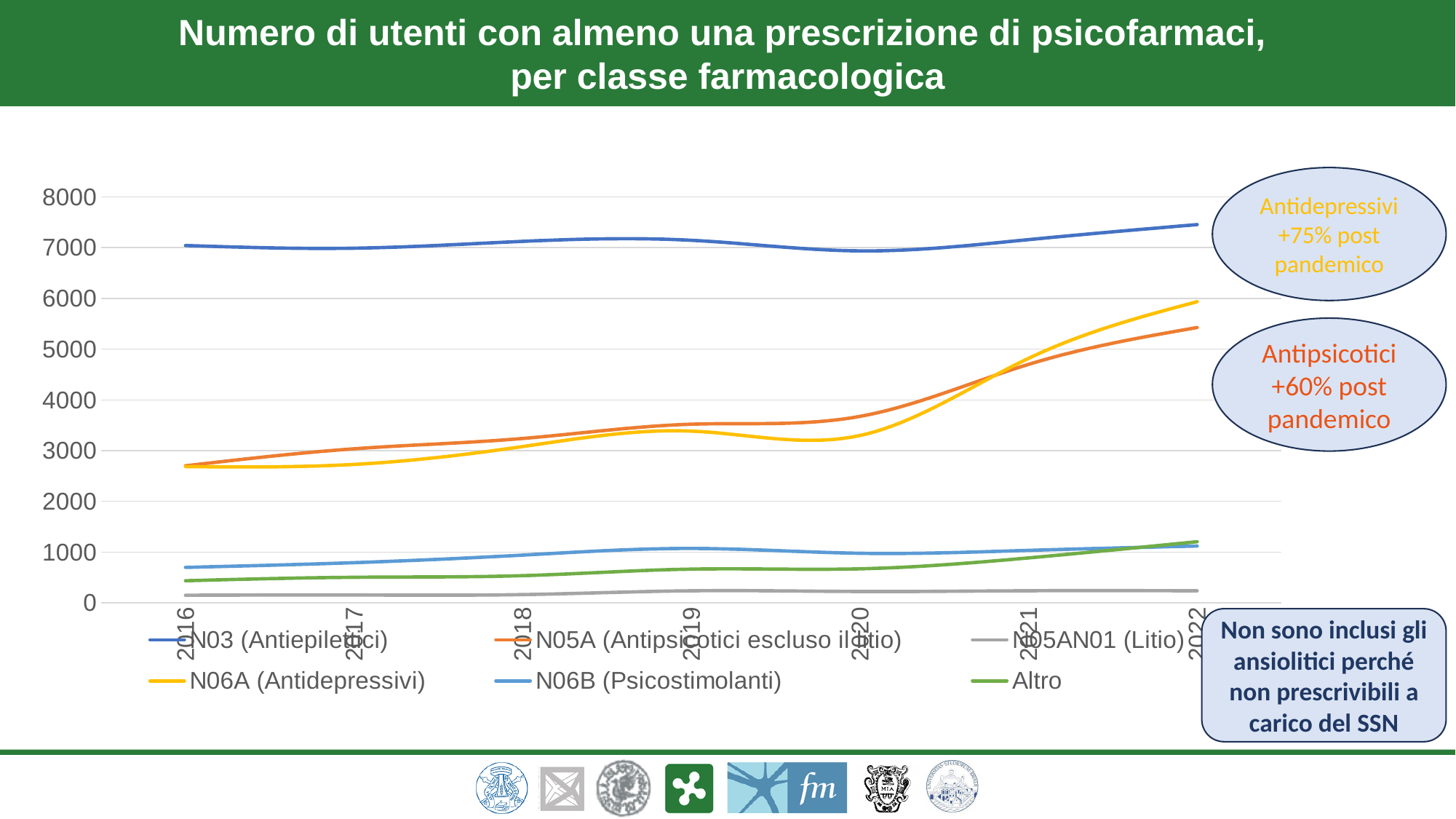
How many series does the legend list? 6 Does the value for N06A (Antidepressivi) rise or fall from 2016 to 2022? rise Which series has the highest value in 2022? N03 (Antiepilettici) Is the value for N06A (Antidepressivi) in 2022 greater or less than 5000? greater In 2022, which is larger: N06A (Antidepressivi) or N05A (Antipsicotici escluso il litio)? N06A (Antidepressivi) What kind of chart is shown on the slide? line chart Is the value for N06B (Psicostimolanti) in 2022 greater or less than 2000? less How many years are shown along the x axis? 7 What is the title of the chart? Numero di utenti con almeno una prescrizione di psicofarmaci, per classe farmacologica Is the value for N05A (Antipsicotici escluso il litio) in 2016 greater or less than 3000? less Which series has the lowest value in 2022? N05AN01 (Litio)